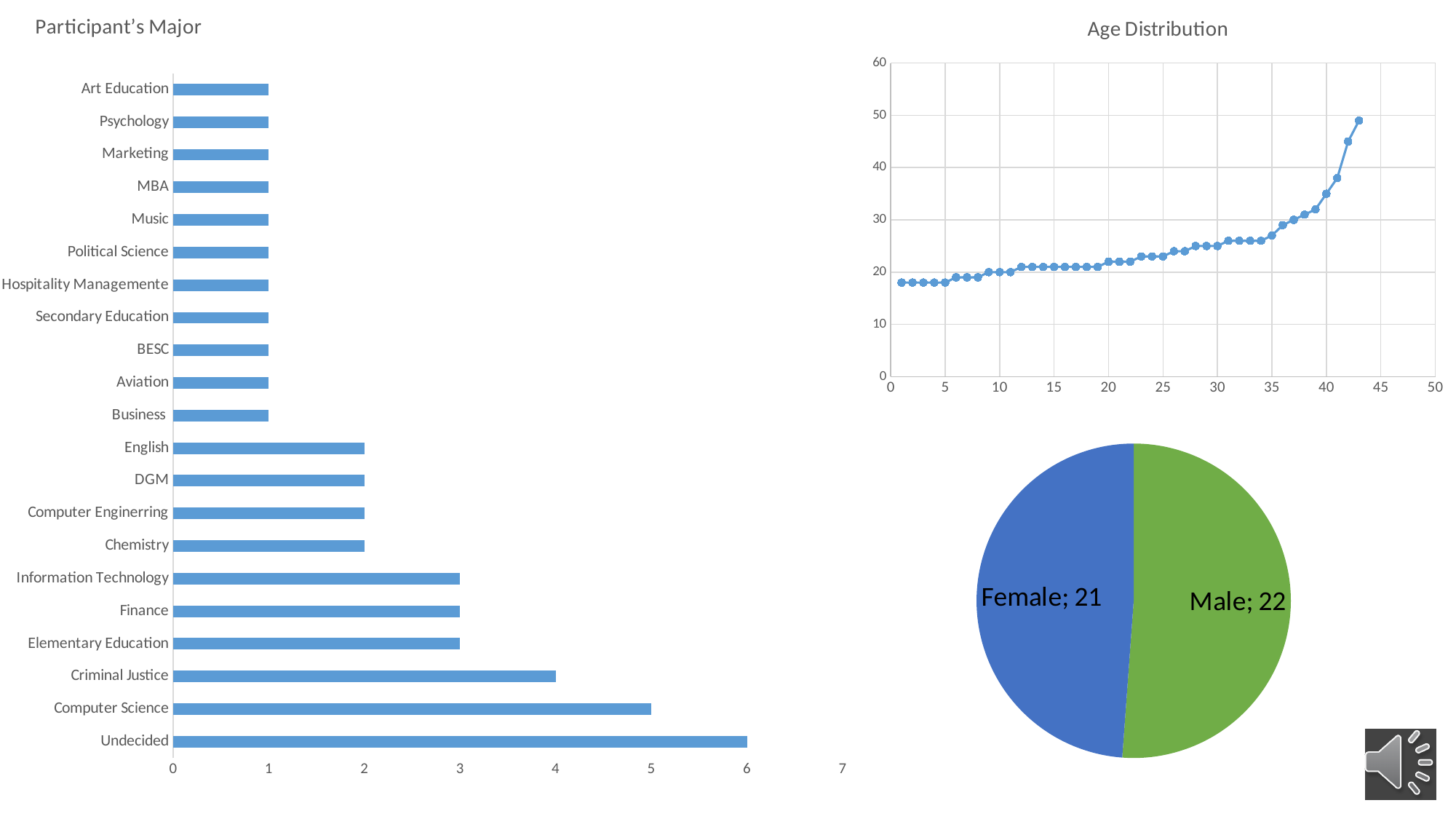
In the Participant's Major chart, what is the difference between Undecided and Computer Science? 1 In the Participant's Major chart, what is the value for Criminal Justice? 4 In the Age Distribution chart, do the values rise or fall along the x axis? rise What kind of chart is the Participant's Major chart? bar chart In the Participant's Major chart, how many categories are shown? 21 In the Participant's Major chart, what is the value for Computer Science? 5 In the pie chart at the bottom right, which slice is larger, Female or Male? Male In the Participant's Major chart, what is the value for Undecided? 6 In the Age Distribution chart, is the value at x = 40 greater or less than 30? greater In the Participant's Major chart, which category has the highest value? Undecided In the Participant's Major chart, which is larger, Finance or Chemistry? Finance In the pie chart at the bottom right, what is the value for Male? 22